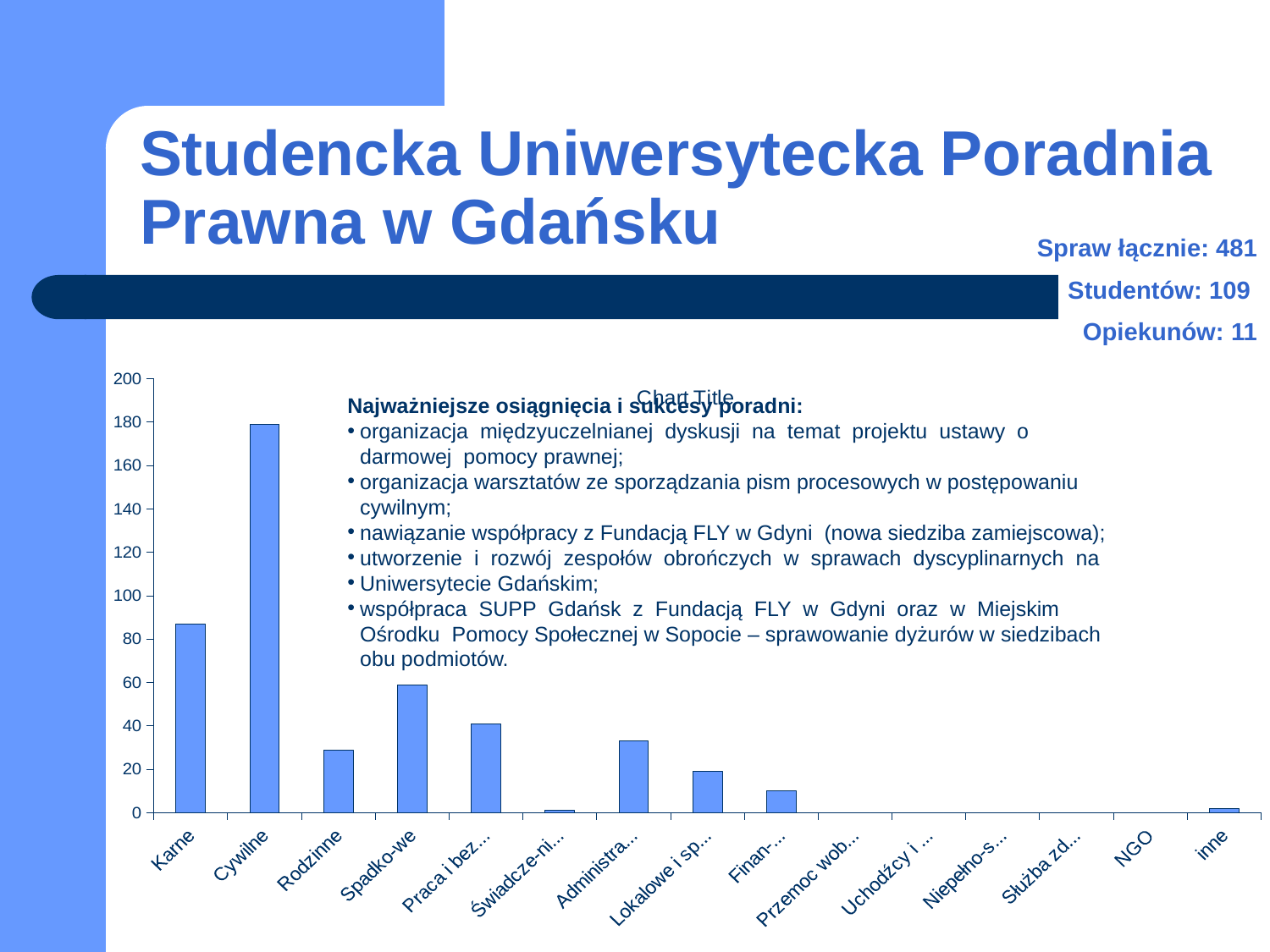
Is the value for Karne greater or less than 60? greater How many categories are shown on the x axis of the chart? 15 Is the value for Rodzinne greater or less than 40? less Is the value for Spadko-we greater or less than 80? less What kind of chart is shown on the slide? bar chart Which category has the highest bar in the chart? Cywilne What is the title shown above the chart? Chart Title Which is larger, the value for Rodzinne or the value for Spadko-we? Spadko-we Which is larger, the value for Karne or the value for Cywilne? Cywilne Which is larger, the value for Administra... or the value for Lokalowe i sp...? Administra...